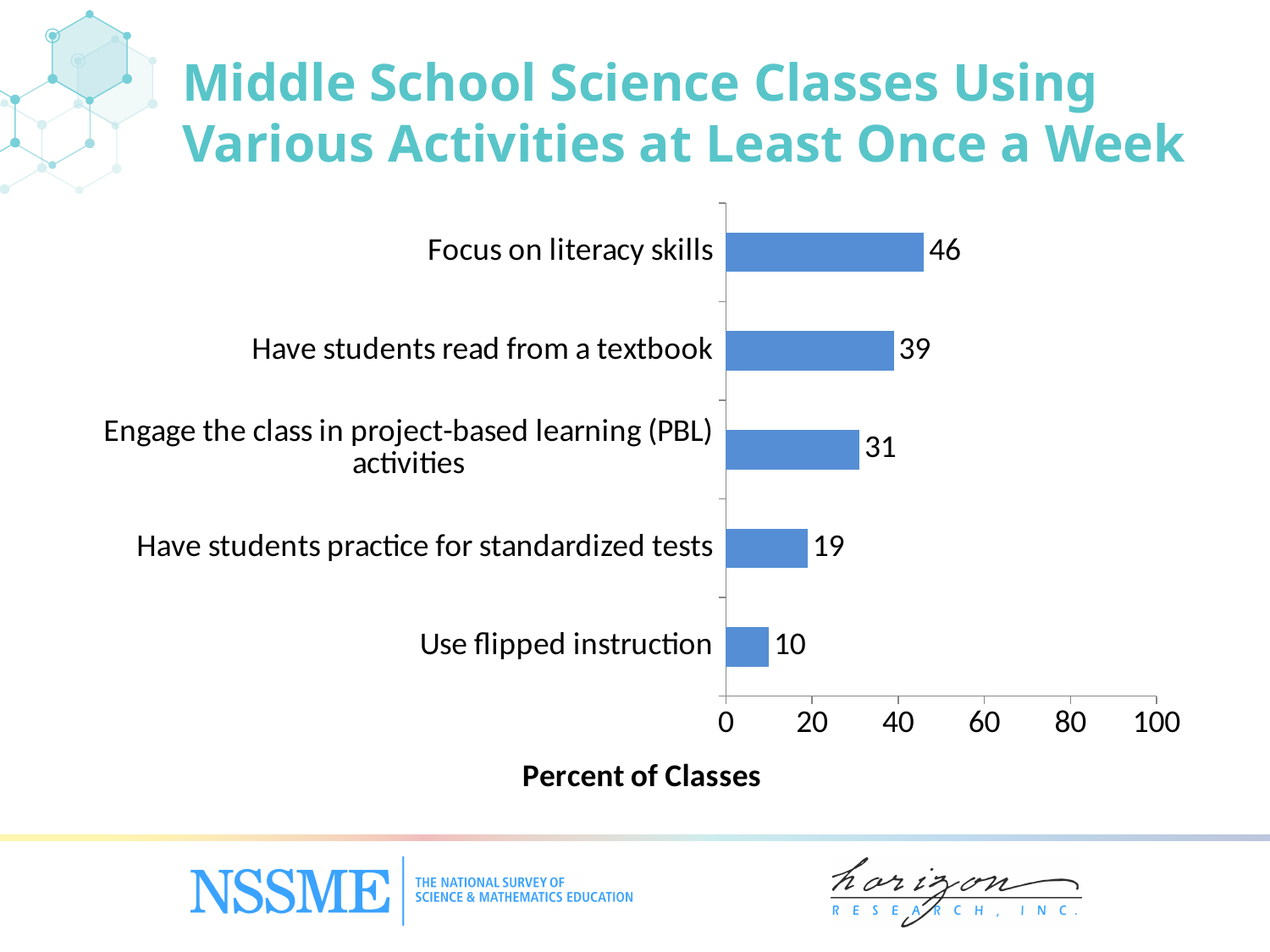
What is the difference between the values for 'Focus on literacy skills' and 'Have students read from a textbook'? 7 What percent of classes engage the class in project-based learning (PBL) activities at least once a week? 31 What is the difference between the values for 'Have students practice for standardized tests' and 'Use flipped instruction'? 9 Which is larger: the value for 'Engage the class in project-based learning (PBL) activities' or 'Have students practice for standardized tests'? Engage the class in project-based learning (PBL) activities What is the value for 'Have students read from a textbook'? 39 What is the label of the horizontal axis? Percent of Classes Which activity has the lowest percent of classes? Use flipped instruction Which activity has the highest percent of classes? Focus on literacy skills What is the value for 'Use flipped instruction'? 10 What kind of chart is shown on the slide? Bar chart How many activities are shown in the chart? 5 What percent of middle school science classes focus on literacy skills at least once a week? 46